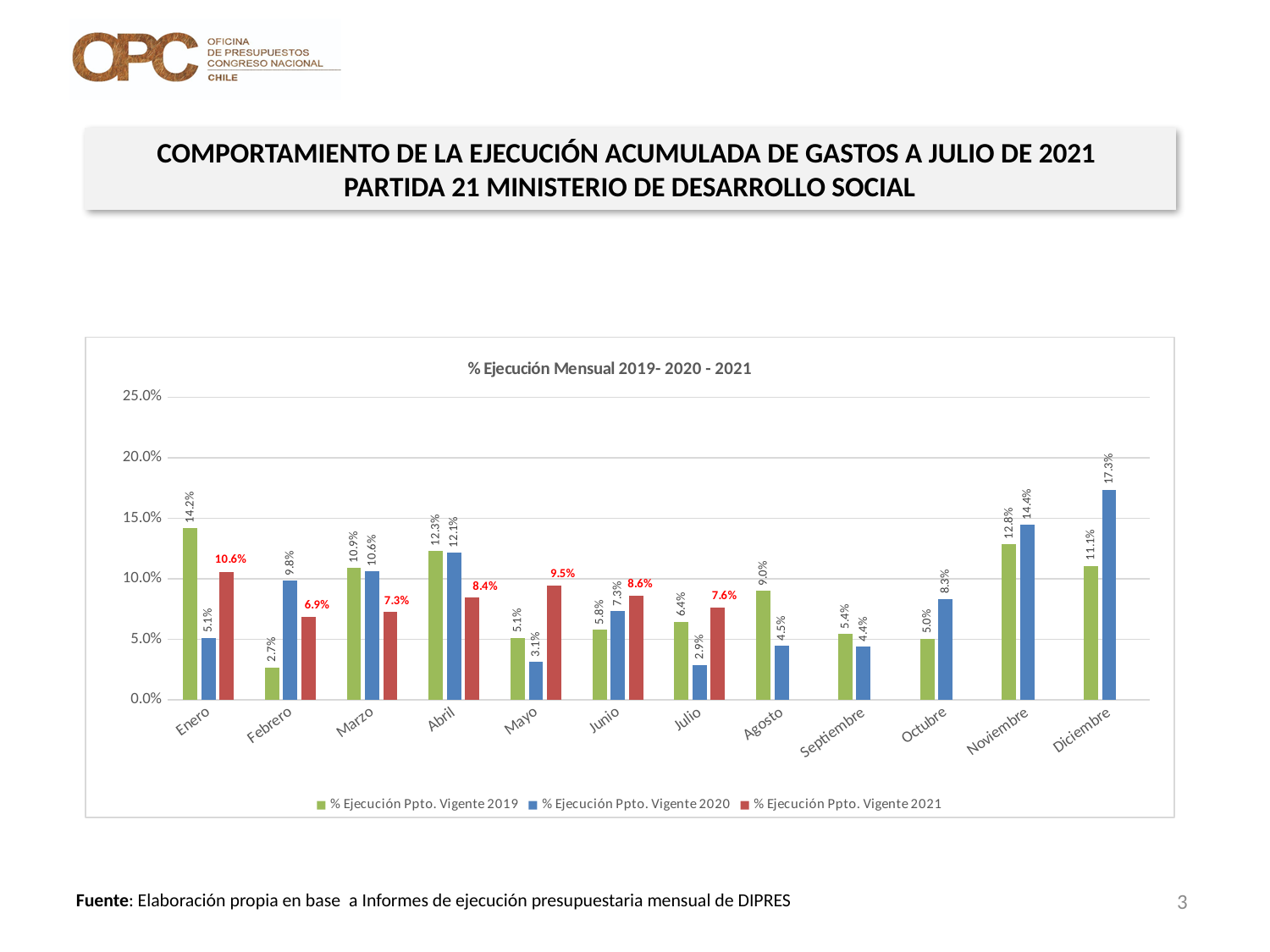
Is the value for Noviembre in the % Ejecución Ppto. Vigente 2020 series greater or less than 10.0%? greater What is the value for Mayo in the % Ejecución Ppto. Vigente 2021 series? 9.5% What is the title of the chart? % Ejecución Mensual 2019- 2020 - 2021 What kind of chart is shown on the slide? Bar chart Which month has the highest value in the % Ejecución Ppto. Vigente 2020 series? Diciembre How many series does the legend list? 3 For Julio, which series has the larger value: % Ejecución Ppto. Vigente 2019 or % Ejecución Ppto. Vigente 2021? % Ejecución Ppto. Vigente 2021 What is the value for Diciembre in the % Ejecución Ppto. Vigente 2020 series? 17.3% Which month has the lowest value in the % Ejecución Ppto. Vigente 2019 series? Febrero What is the difference between the 2019 and 2020 values for Enero? 9.1% What is the value for Enero in the % Ejecución Ppto. Vigente 2019 series? 14.2% How many months are shown on the x axis? 12